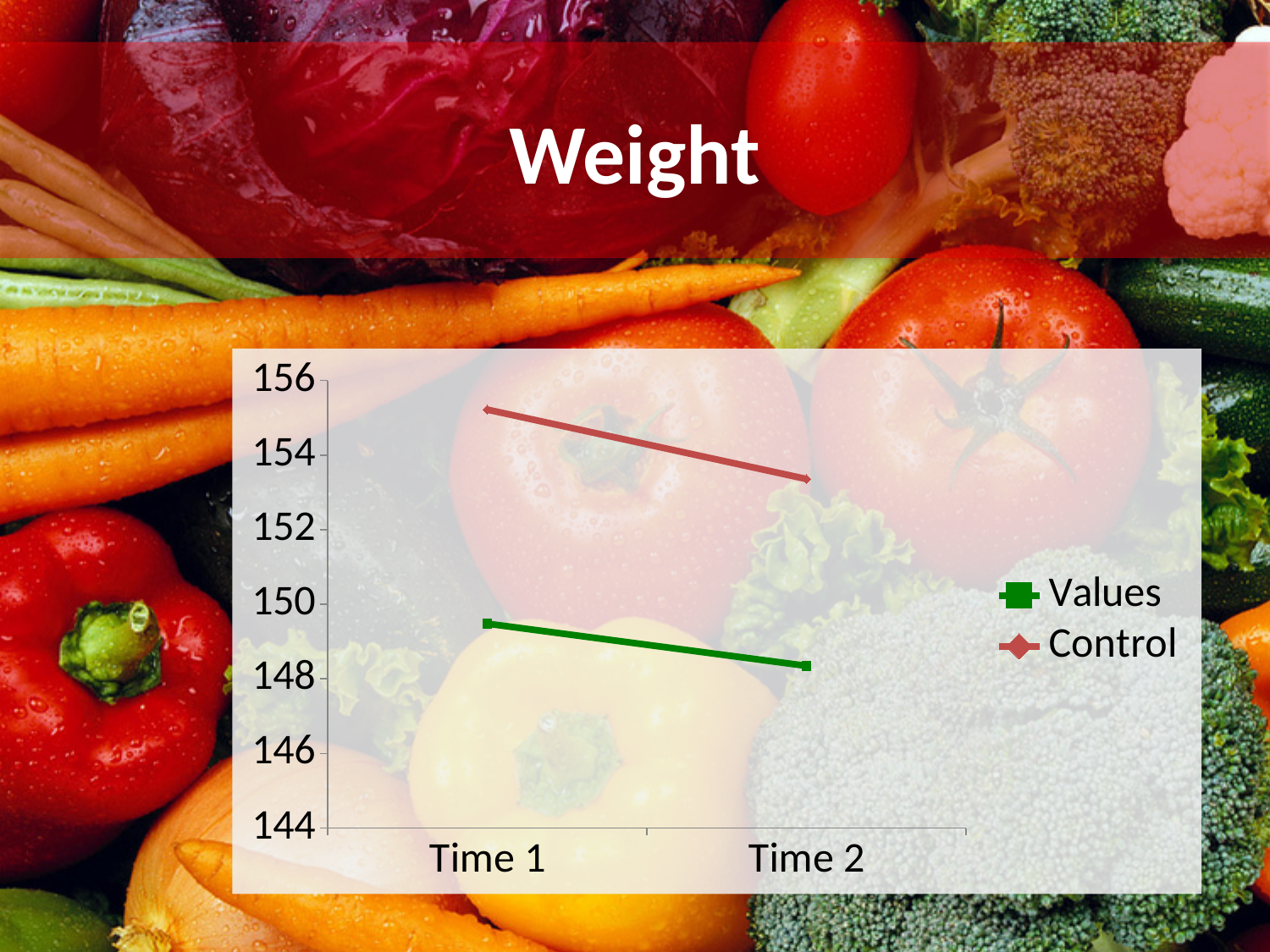
How many series does the legend list? 2 Is the value for Control at Time 1 greater or less than 154? greater What kind of chart is shown on the slide? line chart At Time 2, which series has the lower value, Values or Control? Values Is the value for Control at Time 2 greater or less than 152? greater Does the Values series rise or fall from Time 1 to Time 2? fall At Time 1, which series has the higher value, Values or Control? Control How many time points are shown on the x axis? 2 What colour is the line for the Control series? red Is the value for Values at Time 2 greater or less than 150? less Does the Control series rise or fall from Time 1 to Time 2? fall What is the title of the slide containing the chart? Weight